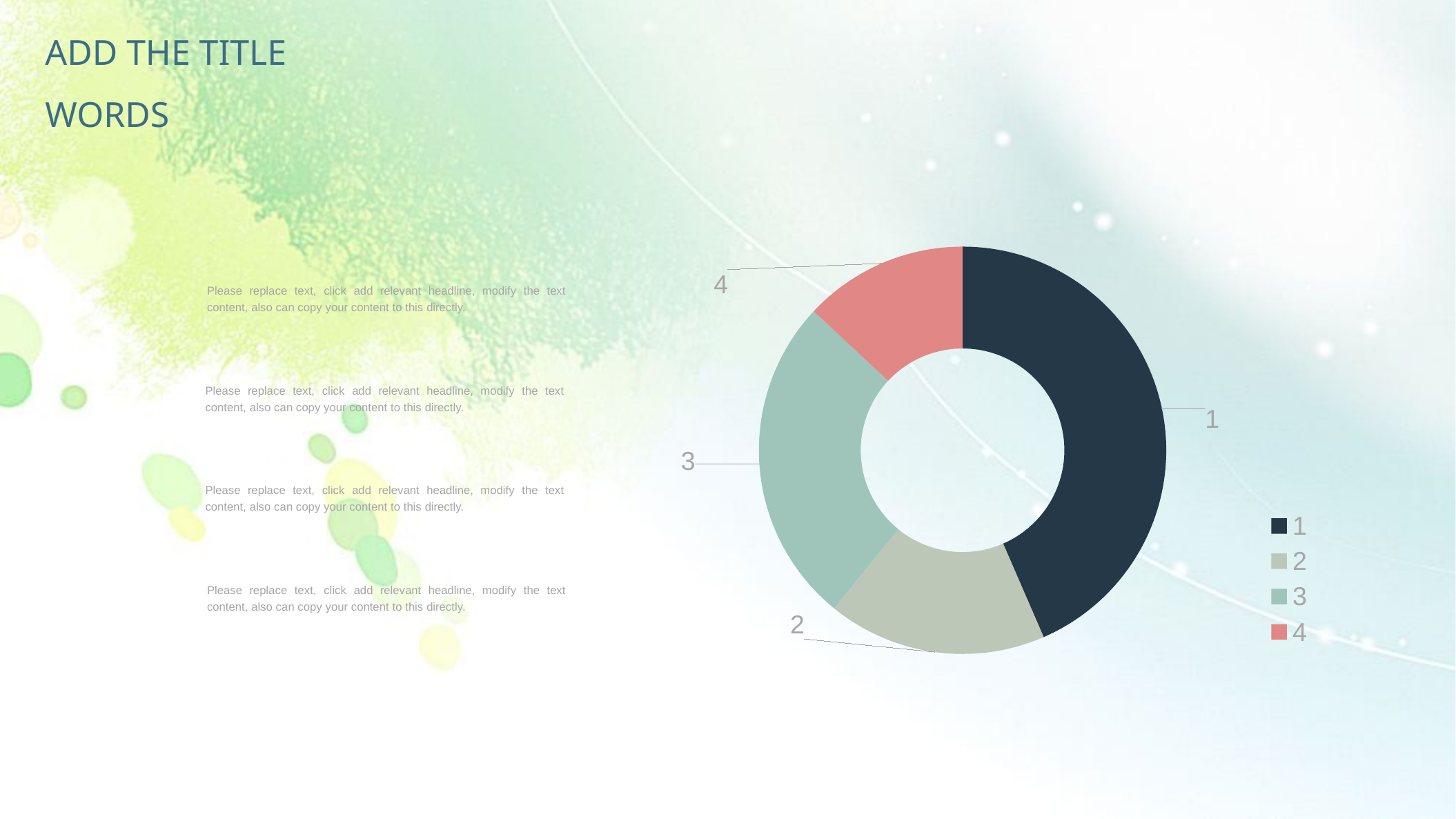
Which slice is larger, category 3 or category 4? 3 Which category has the smallest slice in the doughnut chart? 4 What are the labels listed in the legend, in order? 1, 2, 3, 4 What kind of chart is shown on the slide? doughnut chart Which slice is larger, category 1 or category 4? 1 How many entries does the legend list? 4 Which slice is larger, category 1 or category 2? 1 What colour is the slice for category 4? red Which category has the largest slice in the doughnut chart? 1 How many slices does the doughnut chart have? 4